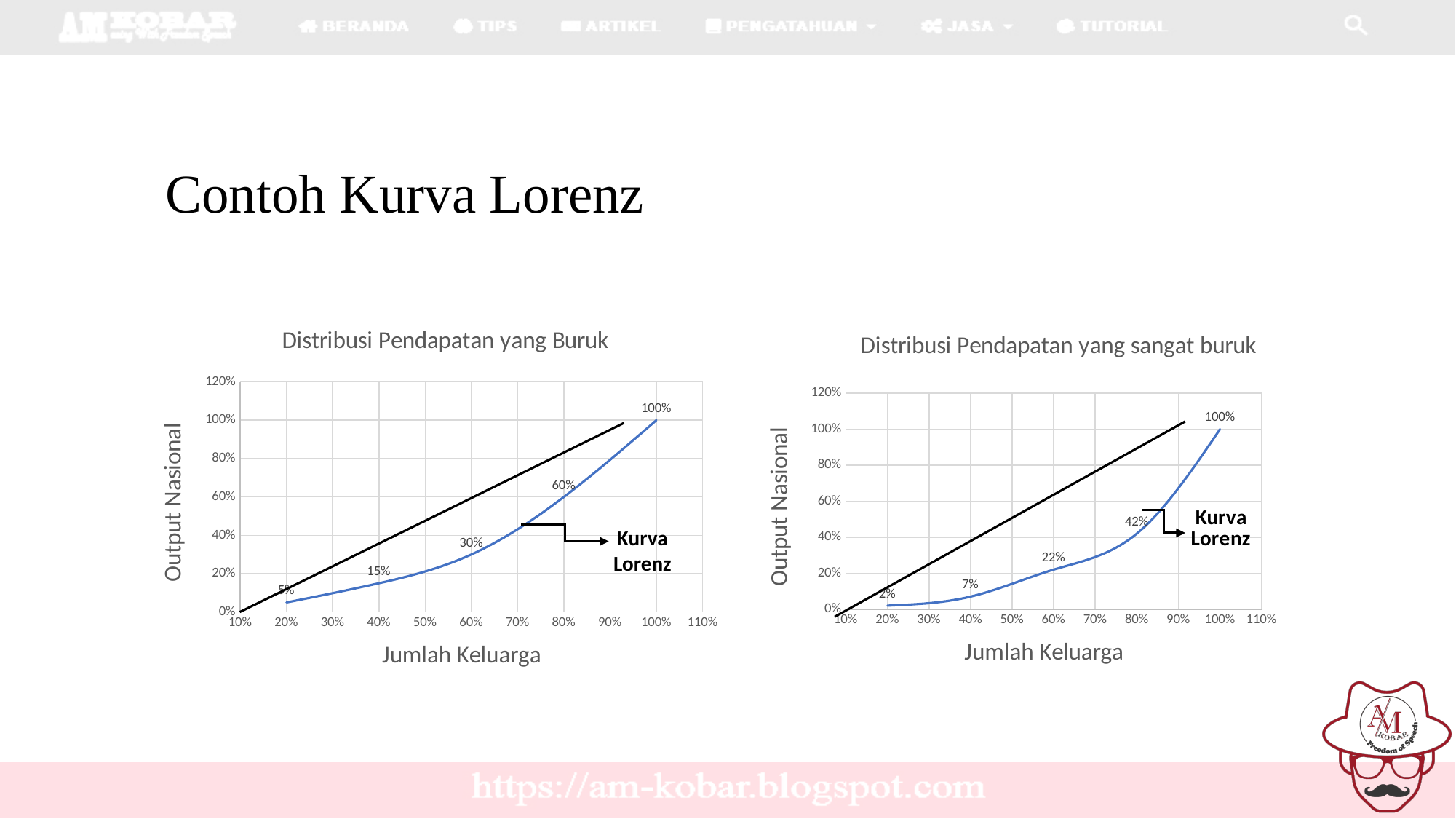
In the chart titled "Distribusi Pendapatan yang sangat buruk", what is the lowest labelled value on the Lorenz curve? 2% In the chart titled "Distribusi Pendapatan yang Buruk", what is the Output Nasional value labelled at 80% Jumlah Keluarga? 60% In the chart titled "Distribusi Pendapatan yang sangat buruk", what is the Output Nasional value labelled at 80% Jumlah Keluarga? 42% What is the title of the vertical axis on the left chart? Output Nasional In the chart titled "Distribusi Pendapatan yang Buruk", what is the Output Nasional value labelled at 40% Jumlah Keluarga? 15% In the chart titled "Distribusi Pendapatan yang sangat buruk", what is the Output Nasional value labelled at 60% Jumlah Keluarga? 22% In the chart titled "Distribusi Pendapatan yang Buruk", what is the lowest labelled value on the Lorenz curve? 5% In the chart titled "Distribusi Pendapatan yang Buruk", what is the difference between the labelled values at 60% and 40% Jumlah Keluarga? 15% What kind of chart is the chart titled "Distribusi Pendapatan yang Buruk"? Line chart In the chart titled "Distribusi Pendapatan yang sangat buruk", does the blue curve rise or fall as Jumlah Keluarga increases? Rise In the chart titled "Distribusi Pendapatan yang sangat buruk", what is the difference between the labelled values at 80% and 60% Jumlah Keluarga? 20% Which chart shows a larger labelled value at 80% Jumlah Keluarga, the left chart or the right chart? The left chart